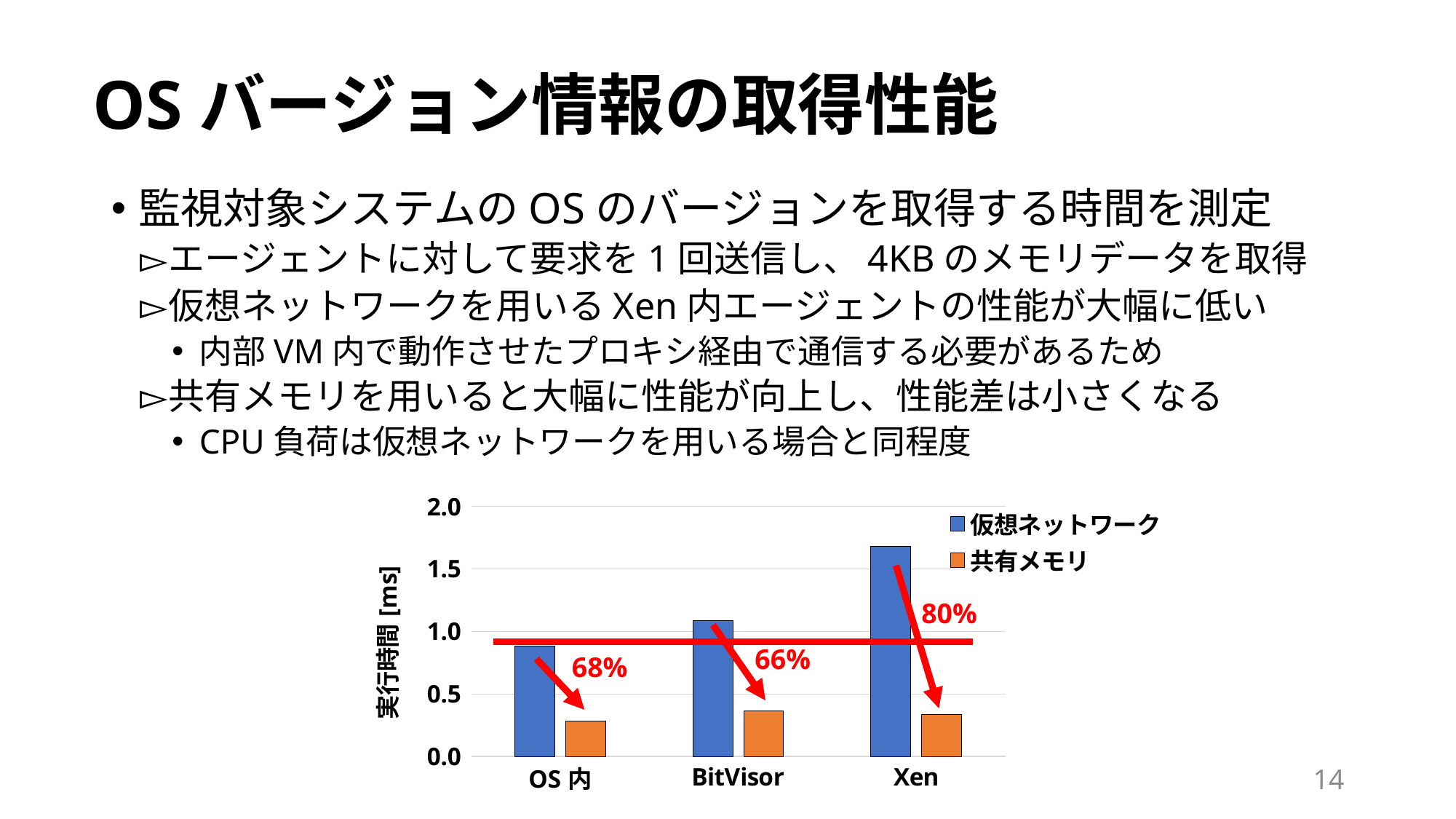
Which category has the lowest value for 仮想ネットワーク? OS 内 Which is larger: the 仮想ネットワーク value for BitVisor or the 仮想ネットワーク value for OS 内? BitVisor What kind of chart is shown on the slide? bar chart Is the 仮想ネットワーク value for OS 内 greater or less than 1.0? less Do the 仮想ネットワーク values rise or fall from OS 内 to Xen along the x axis? rise How many series does the chart's legend list? 2 For Xen, which is larger: the 仮想ネットワーク value or the 共有メモリ value? 仮想ネットワーク Is the 共有メモリ value for BitVisor greater or less than 0.5? less How many categories are shown on the x axis of the chart? 3 Is the 仮想ネットワーク value for Xen greater or less than 1.5? greater Which category has the highest value for 仮想ネットワーク? Xen What is the label of the chart's vertical axis? 実行時間 [ms]